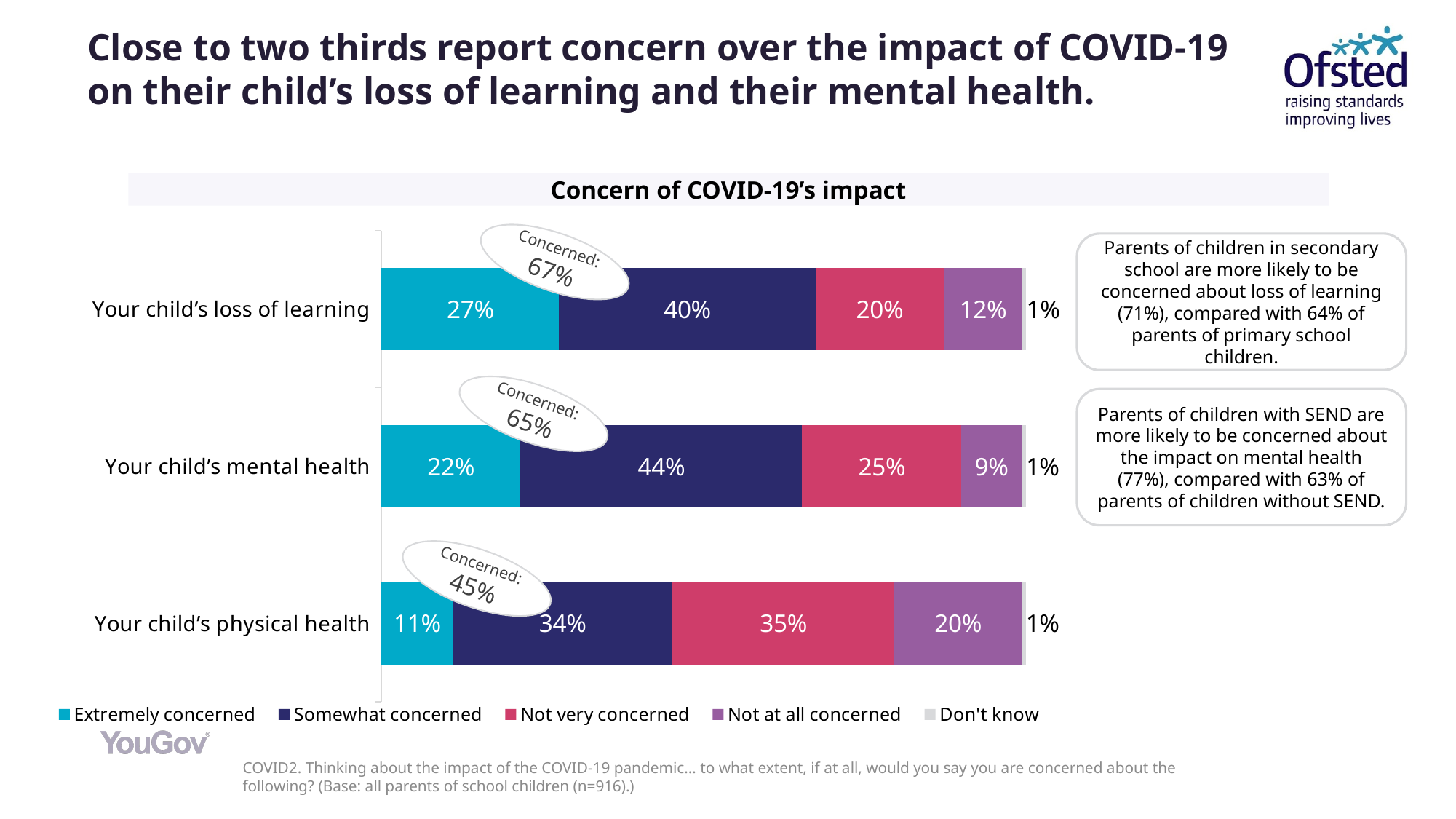
Which category has the lowest combined 'Concerned' percentage? Your child's physical health What is the difference between the 'Concerned' total for loss of learning and for physical health? 22 percentage points How many categories are shown on the chart? 3 What type of chart is shown? Stacked bar chart What percentage of parents are not at all concerned about their child's loss of learning? 12% What is the title of the chart? Concern of COVID-19's impact What percentage of parents are somewhat concerned about their child's mental health? 44% What percentage of parents are extremely concerned about their child's loss of learning? 27% What percentage of parents are not very concerned about their child's physical health? 35% Is the 'Not very concerned' share larger for mental health or for physical health? Physical health How many series does the legend list? 5 Which category has the highest share of parents who are extremely concerned? Your child's loss of learning